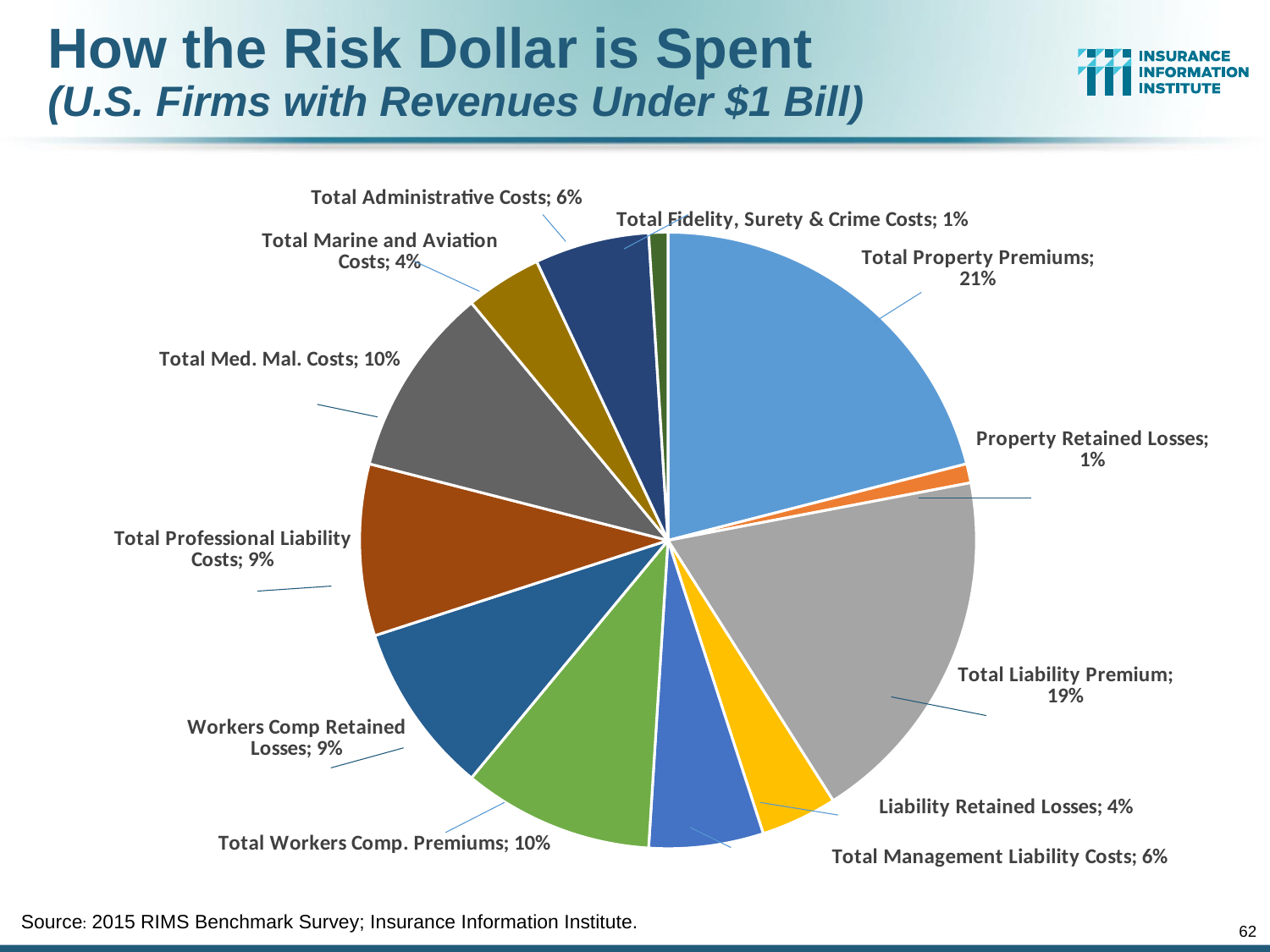
Which is larger, Total Workers Comp. Premiums or Total Management Liability Costs? Total Workers Comp. Premiums What is the difference in percentage points between Total Property Premiums and Total Liability Premium? 2 percentage points What is the value shown for Total Med. Mal. Costs? 10% What is the value shown for Total Marine and Aviation Costs? 4% Which category has the largest slice of the pie? Total Property Premiums What kind of chart is shown on the slide? pie chart What share of the risk dollar goes to Total Liability Premium? 19% How many categories (slices) does the pie chart have? 12 What is the difference in percentage points between Total Administrative Costs and Property Retained Losses? 5 percentage points What is the value shown for Workers Comp Retained Losses? 9% What share of the risk dollar goes to Total Property Premiums? 21% What is the title of the slide containing the chart? How the Risk Dollar is Spent (U.S. Firms with Revenues Under $1 Bill)